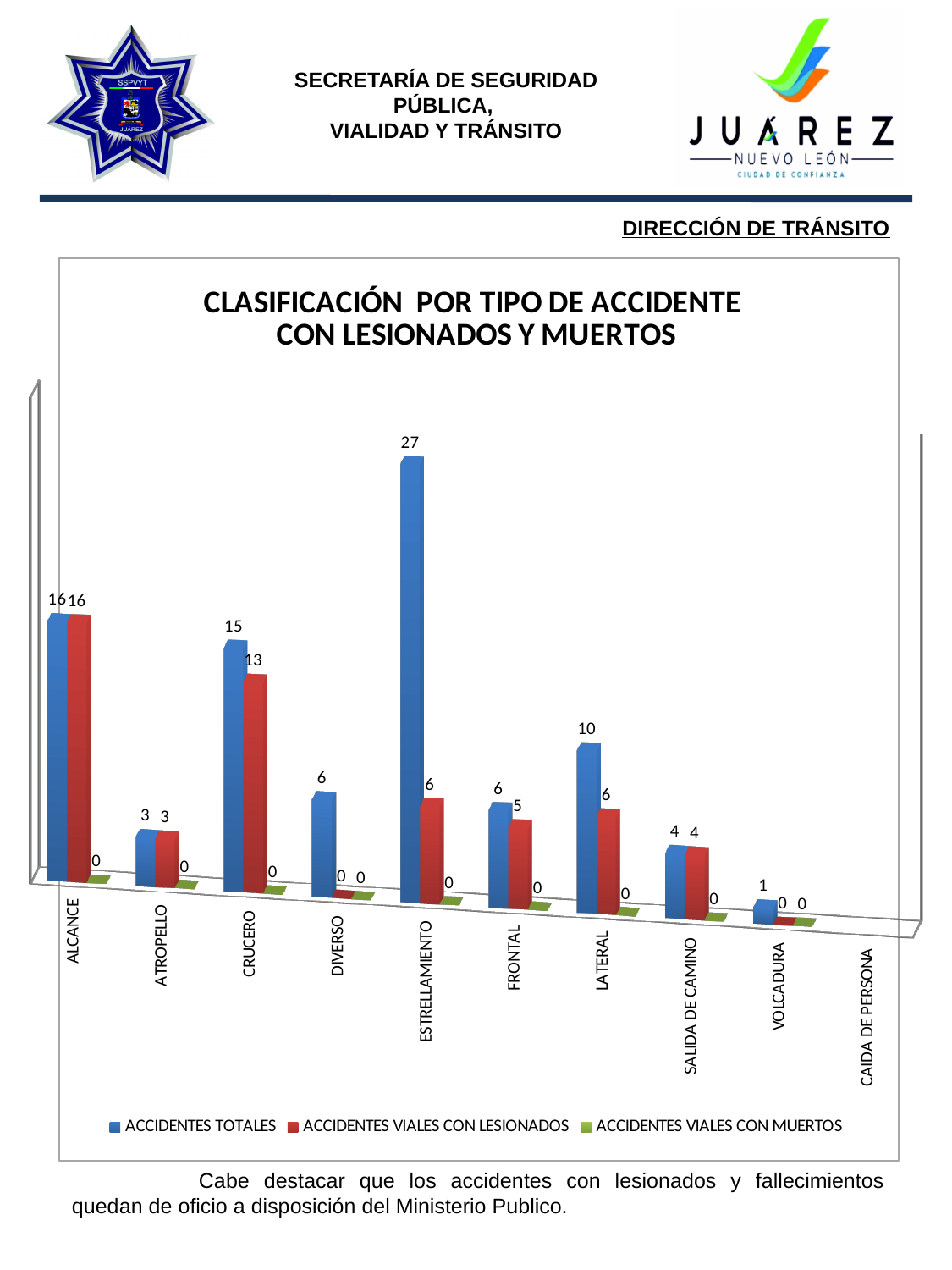
What is the value of ACCIDENTES TOTALES for ESTRELLAMIENTO? 27 What is the difference between ACCIDENTES TOTALES for ALCANCE and for CRUCERO? 1 Which category has the highest value for ACCIDENTES TOTALES? ESTRELLAMIENTO Which is larger, ACCIDENTES TOTALES for LATERAL or ACCIDENTES TOTALES for FRONTAL? LATERAL What is the value of ACCIDENTES VIALES CON LESIONADOS for DIVERSO? 0 What kind of chart is shown on the slide? Bar chart How many categories are shown on the x axis? 10 What is the value of ACCIDENTES TOTALES for LATERAL? 10 Which category has the highest value for ACCIDENTES VIALES CON LESIONADOS? ALCANCE What is the difference between ACCIDENTES TOTALES and ACCIDENTES VIALES CON LESIONADOS for ESTRELLAMIENTO? 21 What is the value of ACCIDENTES VIALES CON LESIONADOS for CRUCERO? 13 How many series does the legend list? 3